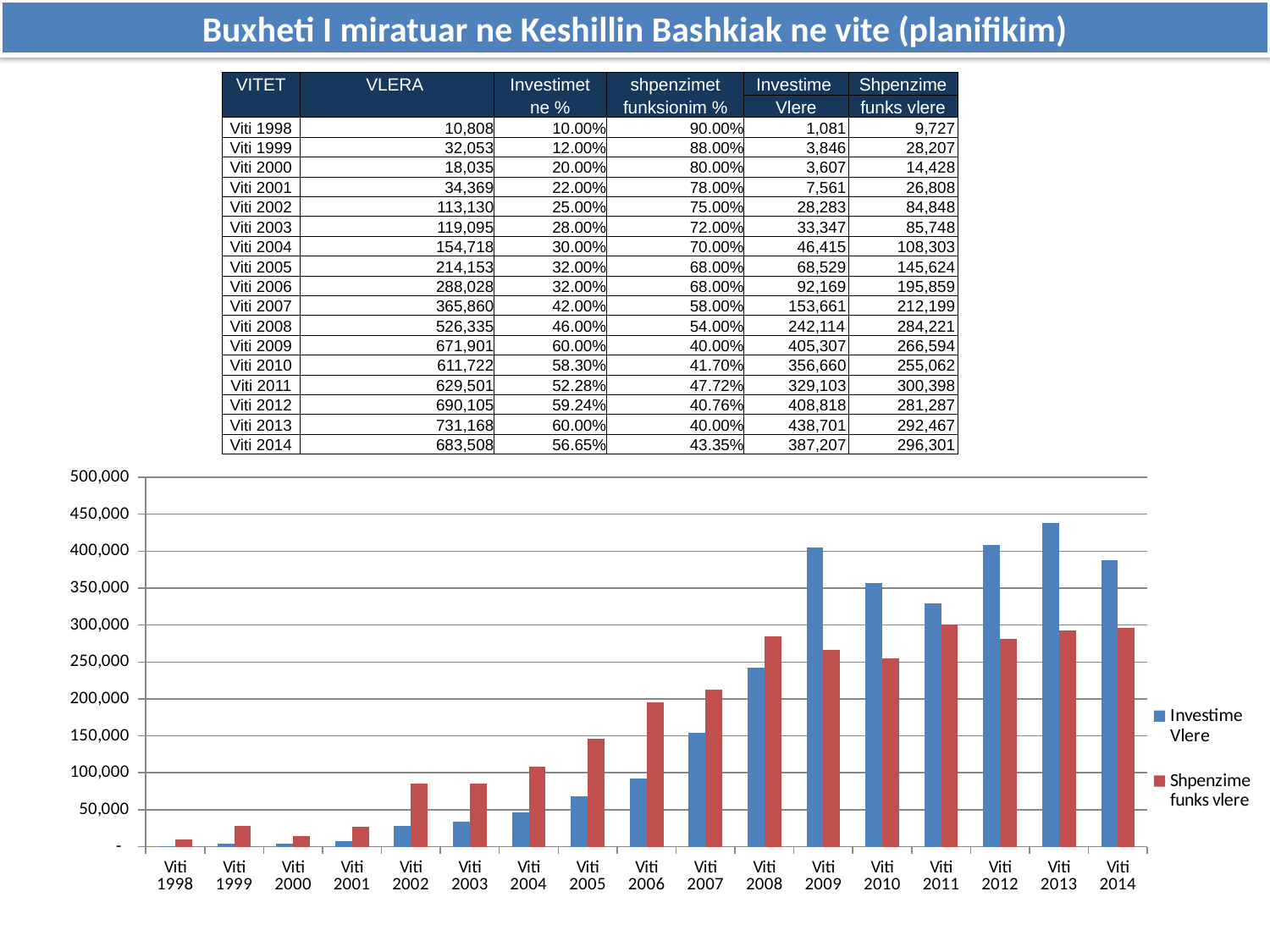
Which year has the highest Investime Vlere bar? Viti 2013 How many years are shown along the x axis of the chart? 17 How many series does the chart legend list? 2 Do the Investime Vlere bars generally rise or fall from Viti 1998 to Viti 2009? Rise For Viti 2009, which is larger: Investime Vlere or Shpenzime funks vlere? Investime Vlere What is the difference between Investime Vlere and Shpenzime funks vlere for Viti 2012? 127,531 What is the Shpenzime funks vlere value for Viti 2008? 284,221 What is the Investime Vlere value for Viti 2009? 405,307 Is the Investime Vlere value for Viti 2013 greater or less than 400,000? greater What kind of chart is shown on the slide? Bar chart Which year has the lowest Investime Vlere bar? Viti 1998 For Viti 2008, which is larger: Investime Vlere or Shpenzime funks vlere? Shpenzime funks vlere